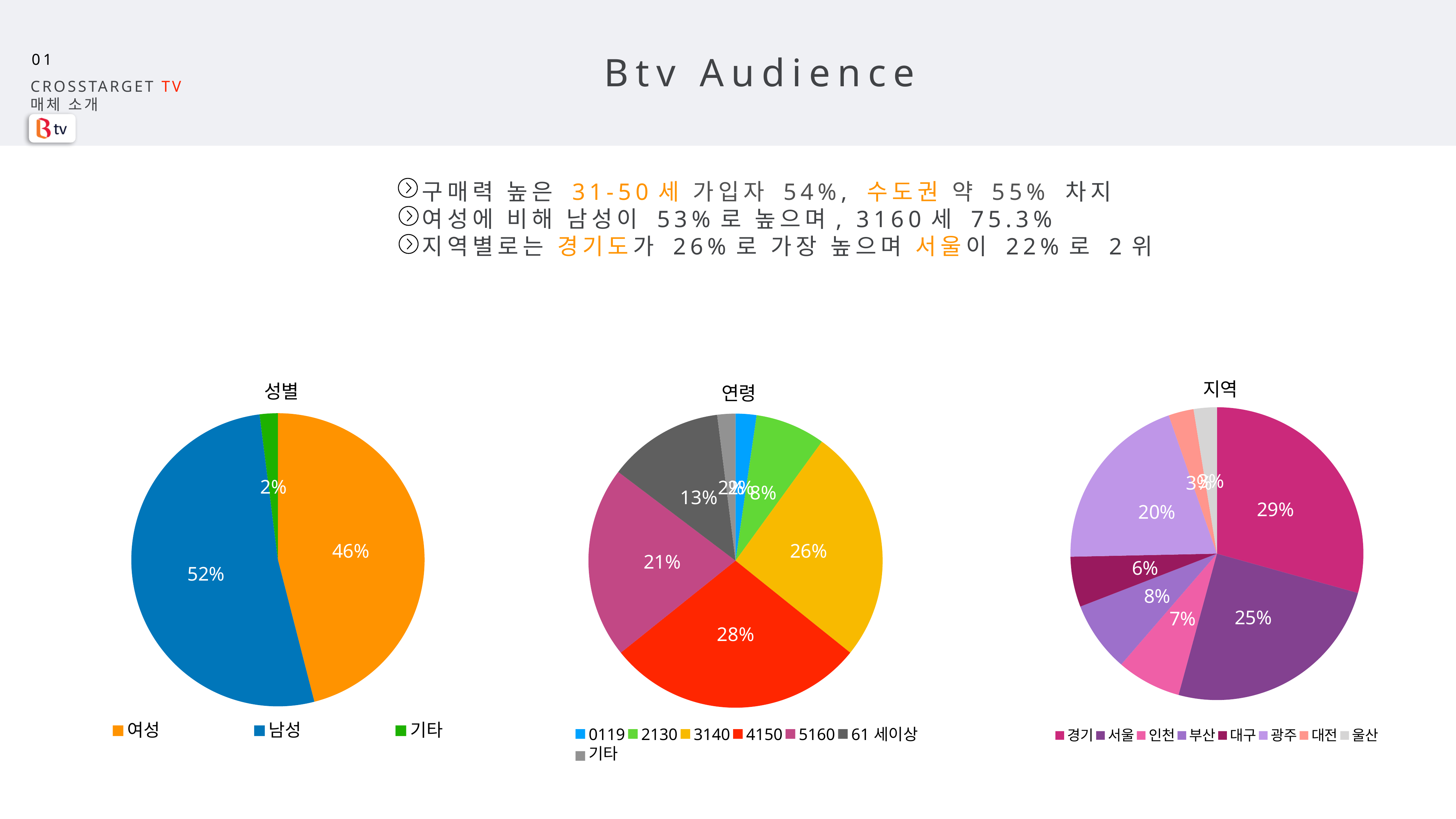
In the 지역 chart, what percentage is 광주? 20% In the 연령 chart, what percentage is 5160? 21% In the 성별 chart, which category has the largest share? 남성 How many entries does the legend of the 지역 chart list? 8 In the 연령 chart, which age group has the largest share? 4150 In the 지역 chart, what percentage is 경기? 29% In the 연령 chart, what percentage is 4150? 28% In the 성별 chart, what percentage is 여성? 46% In the 성별 chart, what is the difference between 남성 and 여성? 6% In the 지역 chart, what is the difference between 경기 and 서울? 4% In the 성별 chart, what percentage is 남성? 52% In the 연령 chart, which is larger, 3140 or 61 세이상? 3140